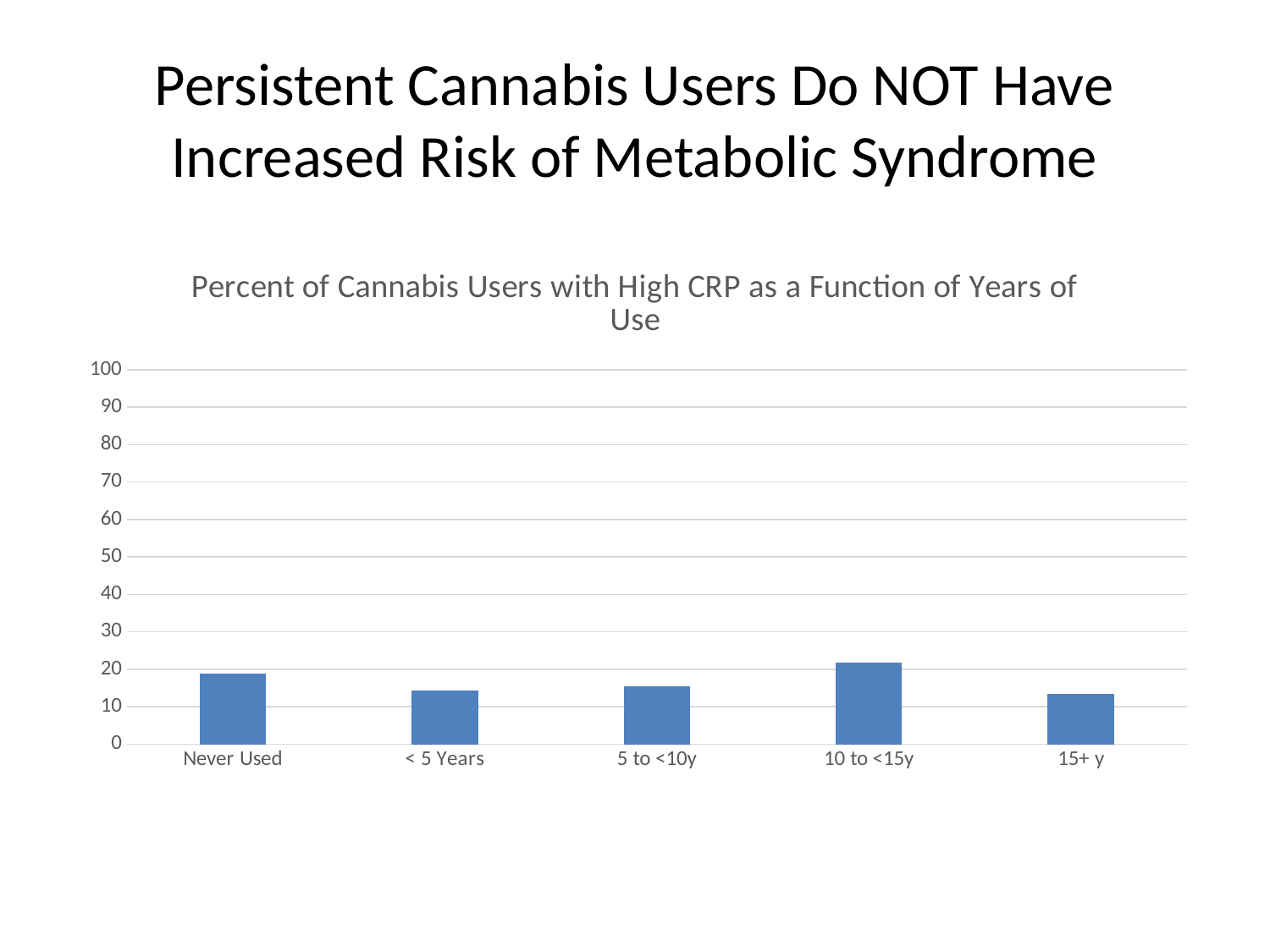
Is the value for Never Used greater or less than 20? less What is the title of the chart? Percent of Cannabis Users with High CRP as a Function of Years of Use How many categories are shown on the x axis of the chart? 5 Which is larger, the value for Never Used or the value for < 5 Years? Never Used What is the highest value shown on the y axis of the chart? 100 Which category has the highest percentage of users with high CRP? 10 to <15y What kind of chart is shown on the slide? bar chart Is the value for 10 to <15y greater or less than 20? greater Is the value for 15+ y greater or less than 20? less Which is larger, the value for 10 to <15y or the value for 15+ y? 10 to <15y